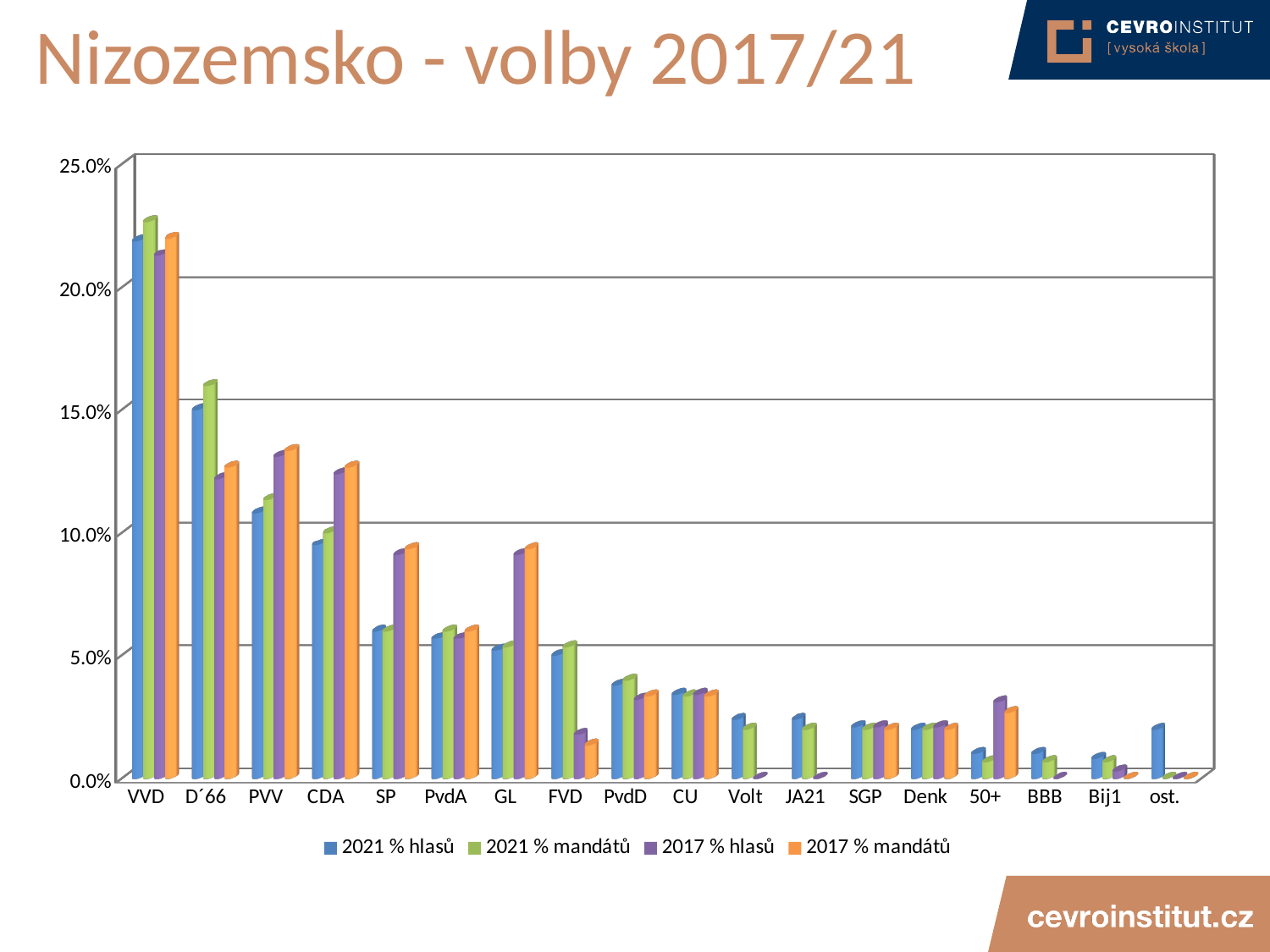
Is the 2017 % hlasů value for FVD greater or less than 5.0%? less For GL, which is larger, the 2017 % hlasů value or the 2021 % hlasů value? 2017 % hlasů Is the 2021 % hlasů value for VVD greater or less than 20.0%? greater Is the 2021 % mandátů value for D´66 greater or less than 15.0%? greater Which is larger, the 2021 % hlasů value for D´66 or for PVV? D´66 Which party has the highest value for 2021 % hlasů? VVD Which series is shown in orange in the legend? 2017 % mandátů How many series does the legend list? 4 What kind of chart is shown on the slide? bar chart How many parties/categories are shown on the x axis? 18 What is the title of the slide containing the chart? Nizozemsko - volby 2017/21